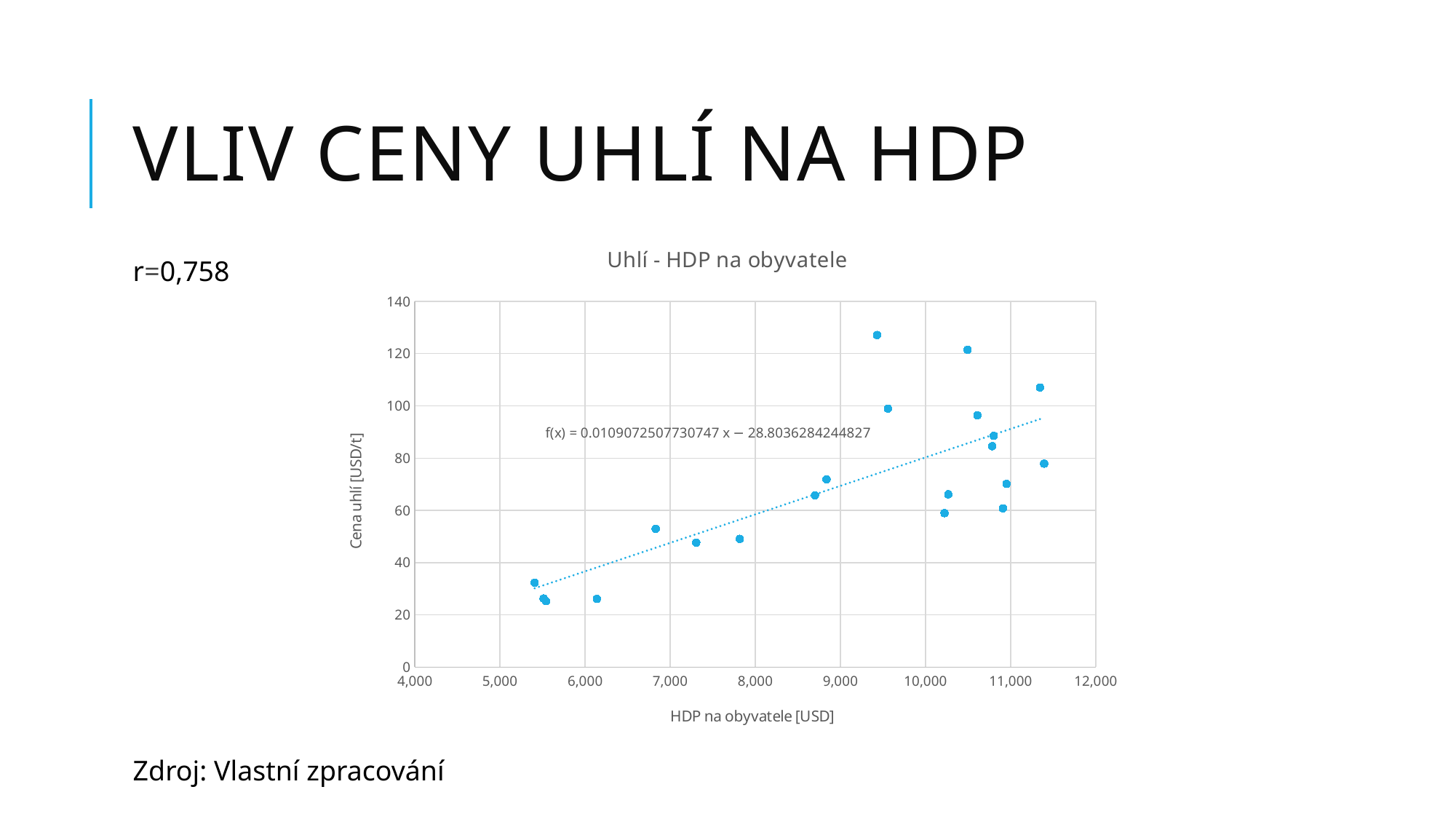
Are the points with HDP na obyvatele below 6,000 USD greater or less than 40 USD/t in coal price? less Is the lowest coal price point on the chart greater or less than 40 USD/t? less Is the coal price for the point with the highest HDP na obyvatele (around 11,400 USD) greater or less than 100 USD/t? less Does the dotted trend line on the chart slope upward or downward? Upward What kind of chart is shown on the slide? Scatter chart What is the title of the chart? Uhlí - HDP na obyvatele What is the label of the vertical axis of the chart? Cena uhlí [USD/t] Do the coal price values generally rise or fall as HDP na obyvatele increases along the x axis? Rise